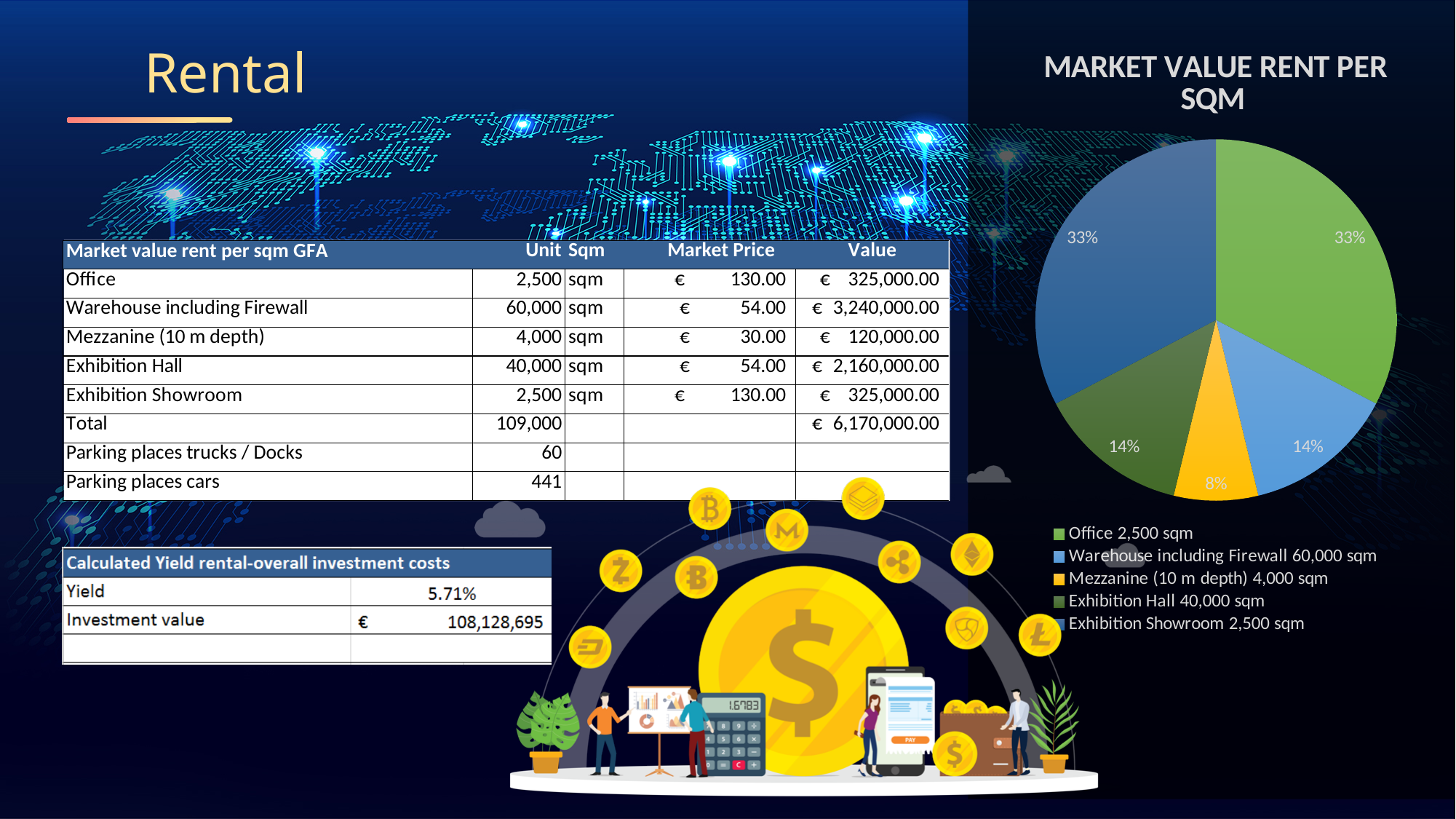
What share of the pie chart does Exhibition Showroom 2,500 sqm represent? 33% What share of the pie chart does Mezzanine (10 m depth) 4,000 sqm represent? 8% What share of the pie chart does Warehouse including Firewall 60,000 sqm represent? 14% What is the difference in percentage points between the Office 2,500 sqm slice and the Mezzanine (10 m depth) 4,000 sqm slice? 25% What is the title of the pie chart? MARKET VALUE RENT PER SQM Which legend entry in the pie chart is shown in orange? Mezzanine (10 m depth) 4,000 sqm Which slice of the pie chart is the smallest? Mezzanine (10 m depth) 4,000 sqm Which slice is larger in the pie chart, Office 2,500 sqm or Mezzanine (10 m depth) 4,000 sqm? Office 2,500 sqm What kind of chart is shown on the slide? pie chart How many slices does the pie chart have? 5